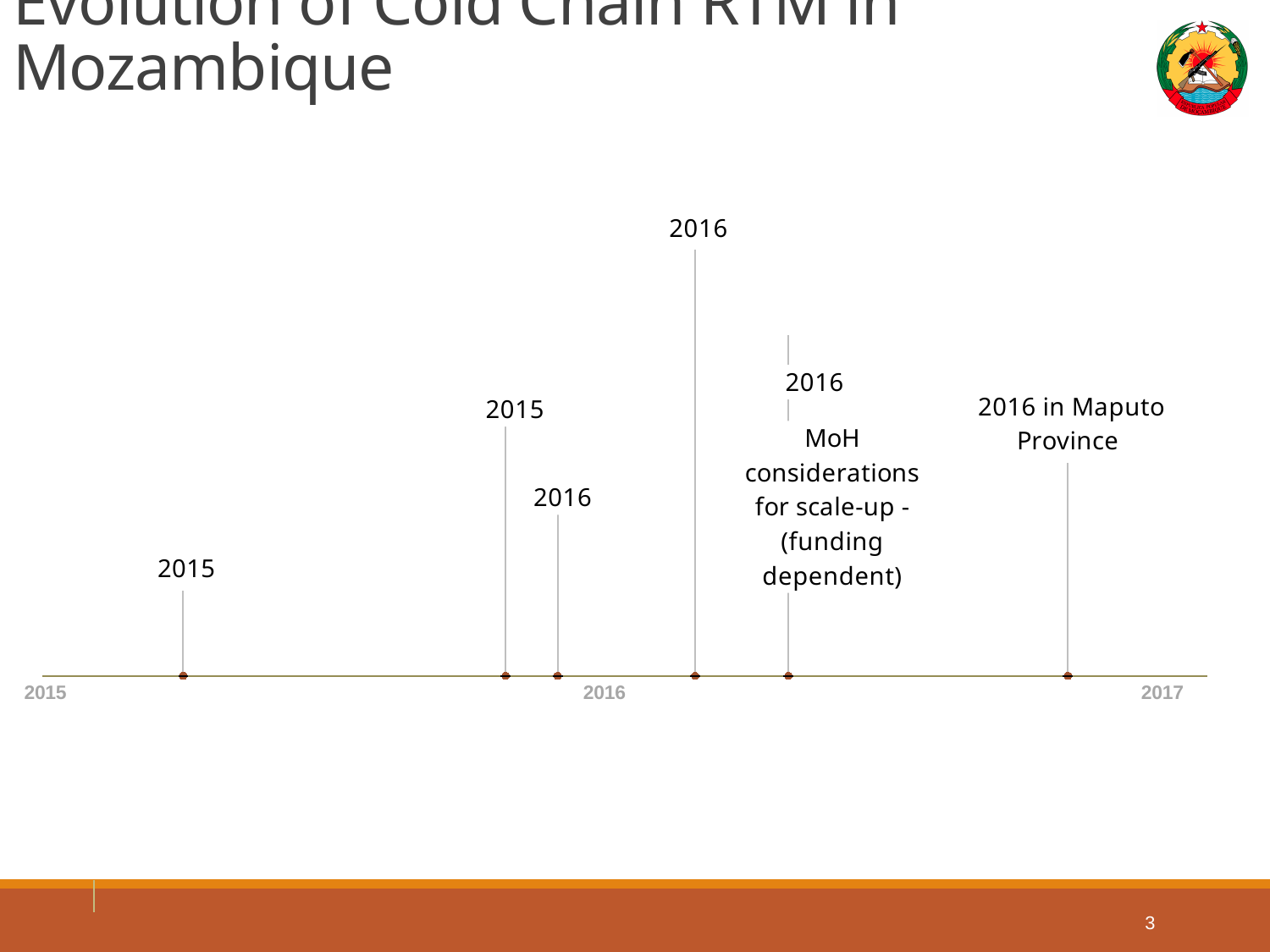
What is the last year label shown at the right end of the timeline axis? 2017 How many event markers are plotted on the timeline? 6 How many events on the timeline are labelled with the year 2015? 2 What is the label of the rightmost event on the timeline? 2016 in Maputo Province Which event on the timeline is described as funding dependent? MoH considerations for scale-up What is the first year label shown at the left end of the timeline axis? 2015 What is the label of the leftmost event on the timeline? 2015 How many year tick labels appear along the timeline axis? 3 What kind of chart is shown on the slide? Timeline Is the event labelled 'MoH considerations for scale-up' placed before or after the 2016 axis tick? after